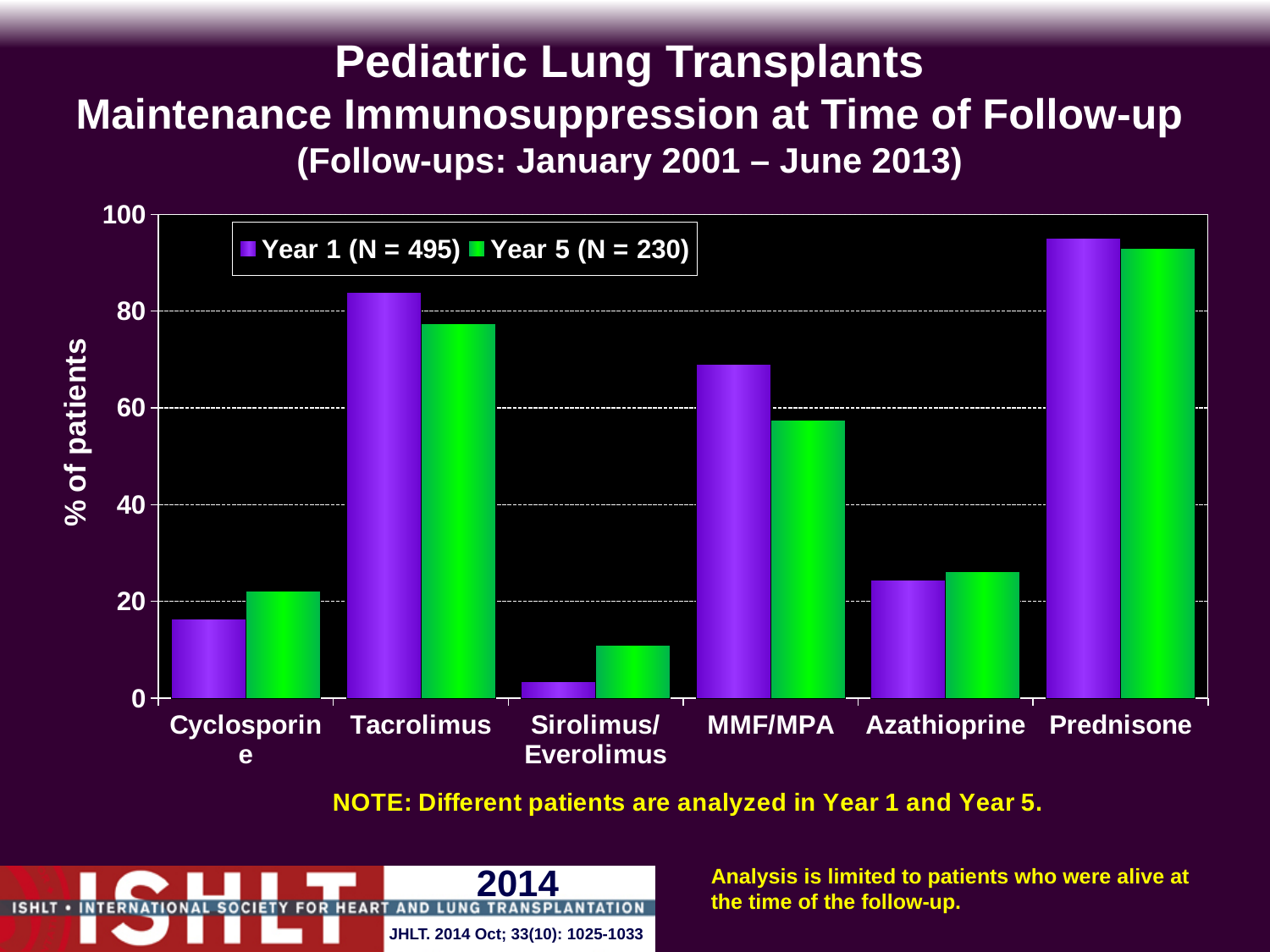
Is the Year 1 value for Cyclosporine greater or less than 20? less Is the Year 1 value for Tacrolimus greater or less than 80? greater How many drug categories are shown on the x axis? 6 What is the label of the y axis? % of patients Is the Year 5 value for MMF/MPA greater or less than 60? less Which drug has the lowest Year 1 percentage of patients? Sirolimus/Everolimus For MMF/MPA, which is larger: the Year 1 value or the Year 5 value? Year 1 How many series does the legend list? 2 What kind of chart is shown on the slide? bar chart Which drug has the lowest Year 5 percentage of patients? Sirolimus/Everolimus For Cyclosporine, which is larger: the Year 1 value or the Year 5 value? Year 5 Which drug has the highest Year 1 percentage of patients? Prednisone